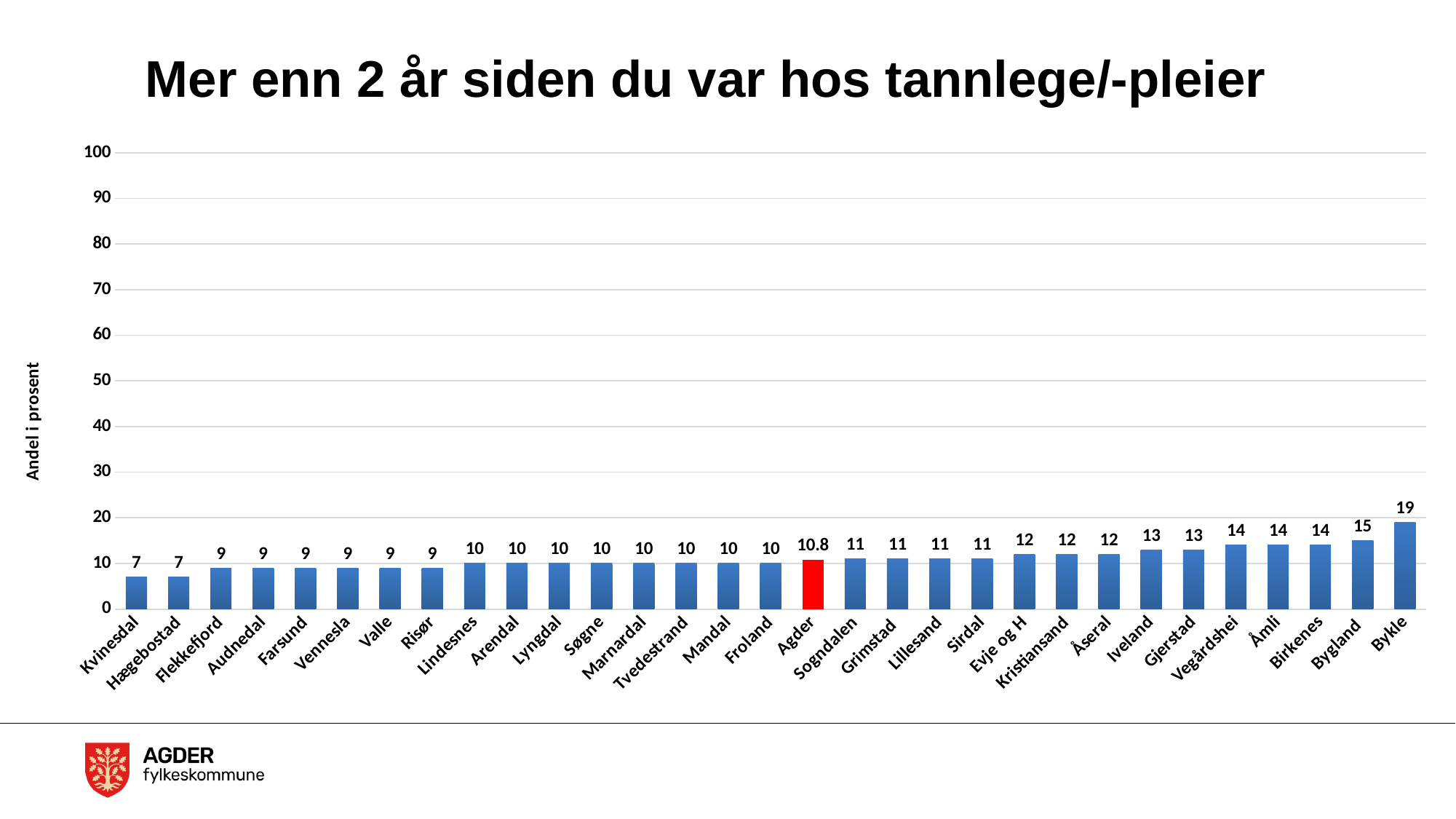
Which municipality has the highest value? Bykle Which bar is coloured red instead of blue? Agder How many municipalities/categories are shown on the chart? 31 What is the value for Agder? 10.8 Which has a larger value, Bygland or Iveland? Bygland What kind of chart is shown on the slide? Bar chart What is the value for Bykle? 19 What is the value for Arendal? 10 What is the lowest value shown on the chart? 7 What is the value for Kristiansand? 12 What is the difference between the values for Bykle and Kvinesdal? 12 Is the value for Bykle greater or less than 10? greater